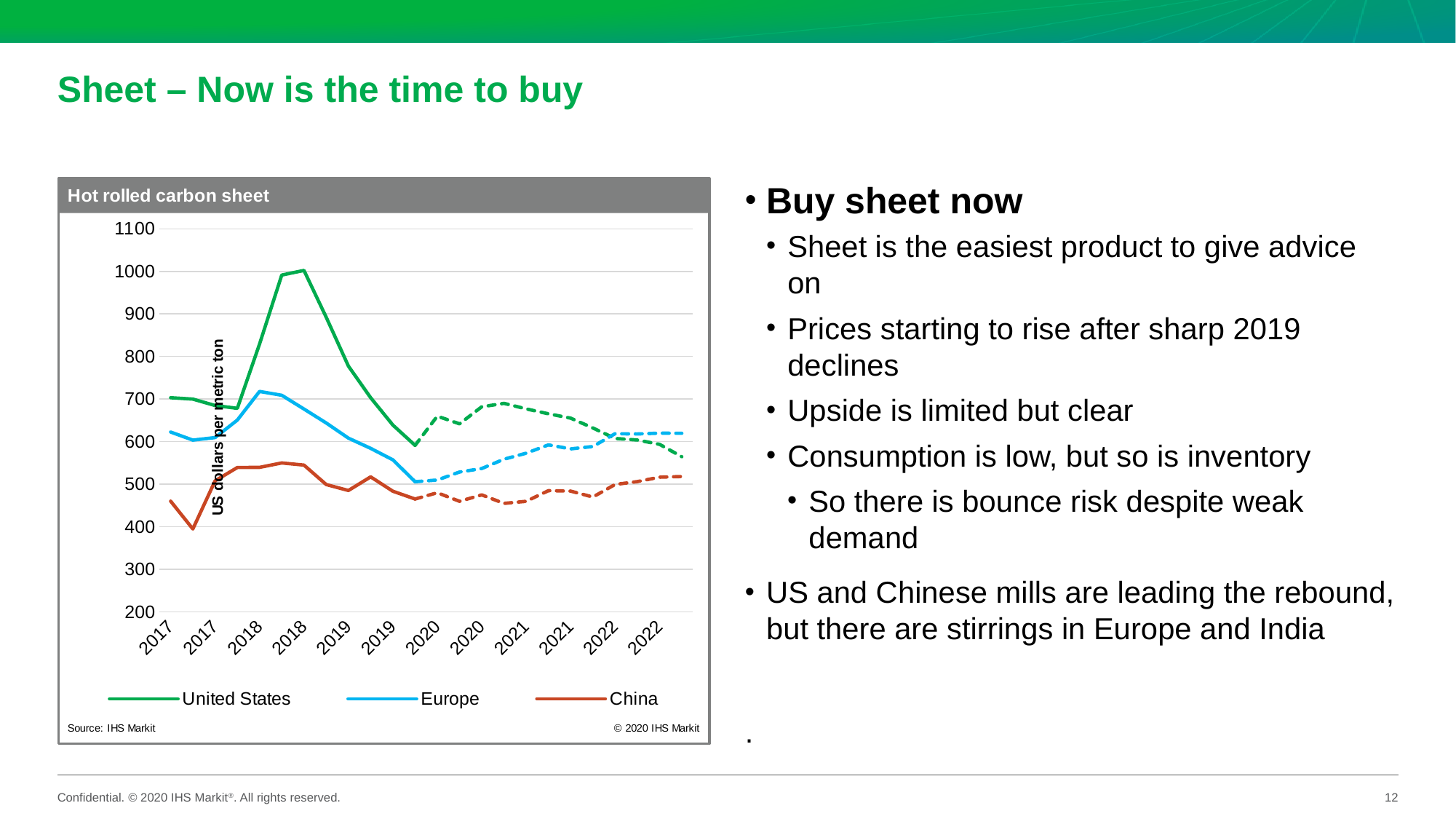
In 2018, which is higher: the United States line or the China line? United States Is the lowest value of the China line in 2017 greater or less than 500? less Is the value of the United States line at the end of 2022 greater or less than 600? less Is the peak value of the United States line in 2018 greater or less than 900? greater Does the United States line rise or fall from its 2018 peak to 2020? fall What kind of chart is shown under the title 'Hot rolled carbon sheet'? line chart Which series reaches the highest value on the 'Hot rolled carbon sheet' chart? United States How many series does the legend of the 'Hot rolled carbon sheet' chart list? 3 How many year labels are shown along the x axis of the 'Hot rolled carbon sheet' chart? 12 What is the label on the vertical axis of the 'Hot rolled carbon sheet' chart? US dollars per metric ton Which series are listed in the legend of the 'Hot rolled carbon sheet' chart? United States, Europe, China Which series has the lowest values overall on the 'Hot rolled carbon sheet' chart? China